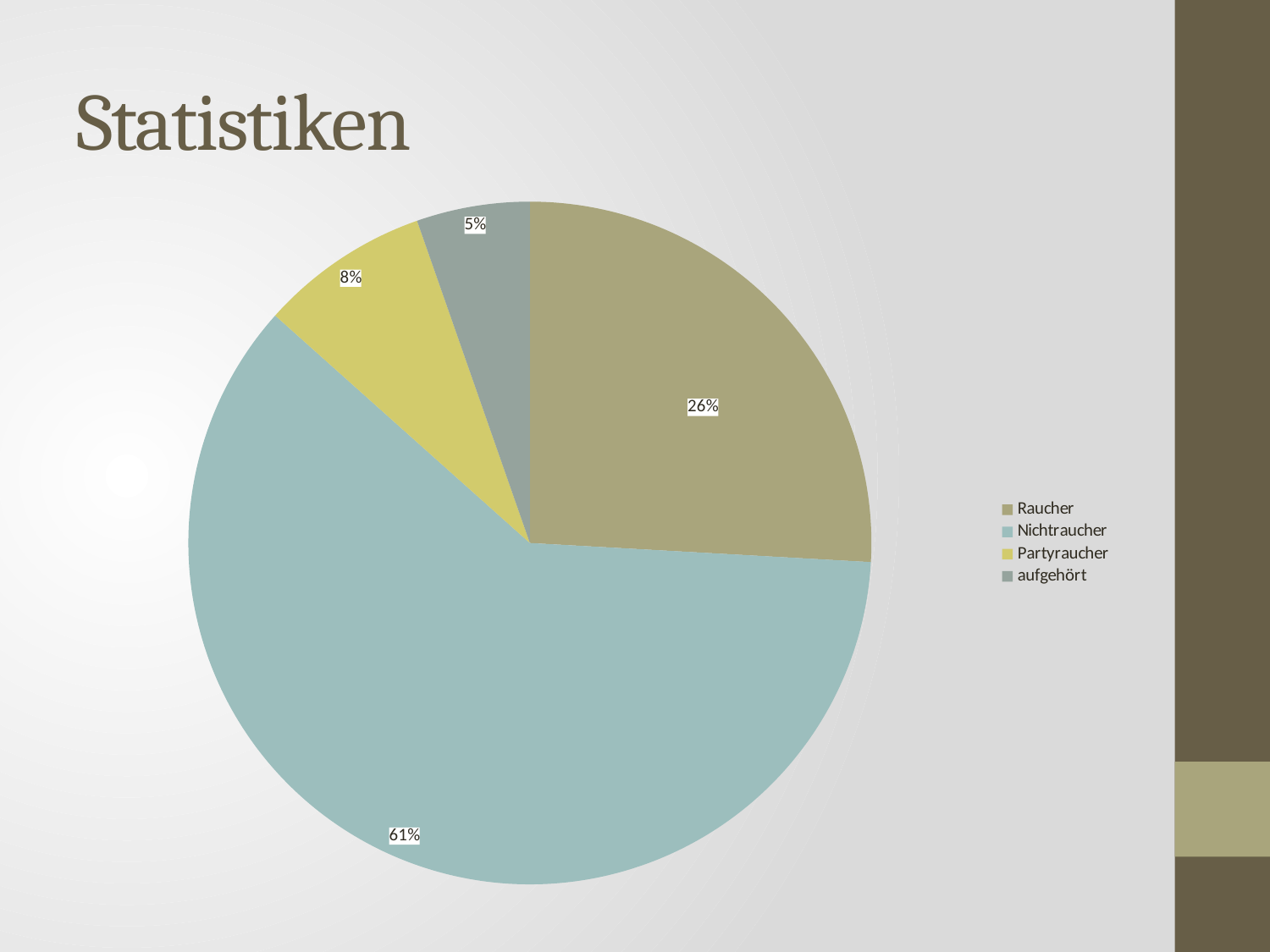
What is the title of the slide containing the pie chart? Statistiken What share of the pie does Nichtraucher have? 61% Which is larger, the Partyraucher slice or the aufgehört slice? Partyraucher What share of the pie does aufgehört have? 5% Which category has the largest slice of the pie? Nichtraucher How many slices does the pie chart have? 4 What kind of chart is shown on the slide? pie chart What share of the pie does Partyraucher have? 8% What is the difference in percentage points between Nichtraucher and Raucher? 35 How many entries does the legend list? 4 Which category has the smallest slice of the pie? aufgehört